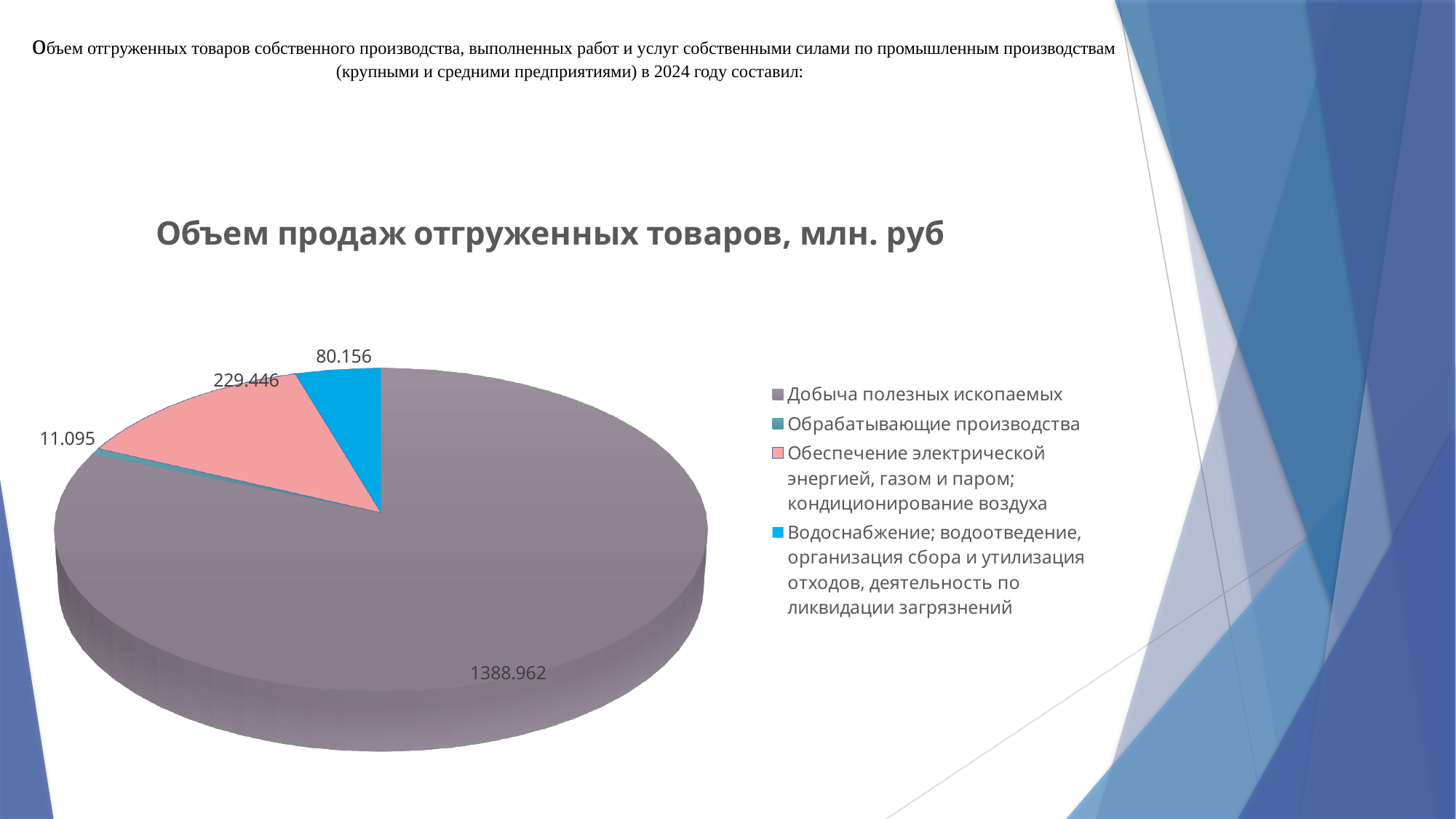
Which category has the largest slice of the pie? Добыча полезных ископаемых Which category has the smallest slice of the pie? Обрабатывающие производства Which is larger: the value for Водоснабжение; водоотведение, организация сбора и утилизация отходов, деятельность по ликвидации загрязнений or the value for Обрабатывающие производства? Водоснабжение; водоотведение, организация сбора и утилизация отходов, деятельность по ликвидации загрязнений What is the value for Водоснабжение; водоотведение, организация сбора и утилизация отходов, деятельность по ликвидации загрязнений? 80.156 What is the value for Добыча полезных ископаемых? 1388.962 What is the value for Обеспечение электрической энергией, газом и паром; кондиционирование воздуха? 229.446 What is the value for Обрабатывающие производства? 11.095 What is the title of the chart? Объем продаж отгруженных товаров, млн. руб How many categories does the pie chart show? 4 What is the difference between the values for Добыча полезных ископаемых and Обеспечение электрической энергией, газом и паром; кондиционирование воздуха? 1159.516 What type of chart is shown on the slide? Pie chart What is the difference between the values for Обеспечение электрической энергией, газом и паром; кондиционирование воздуха and Водоснабжение; водоотведение, организация сбора и утилизация отходов, деятельность по ликвидации загрязнений? 149.290